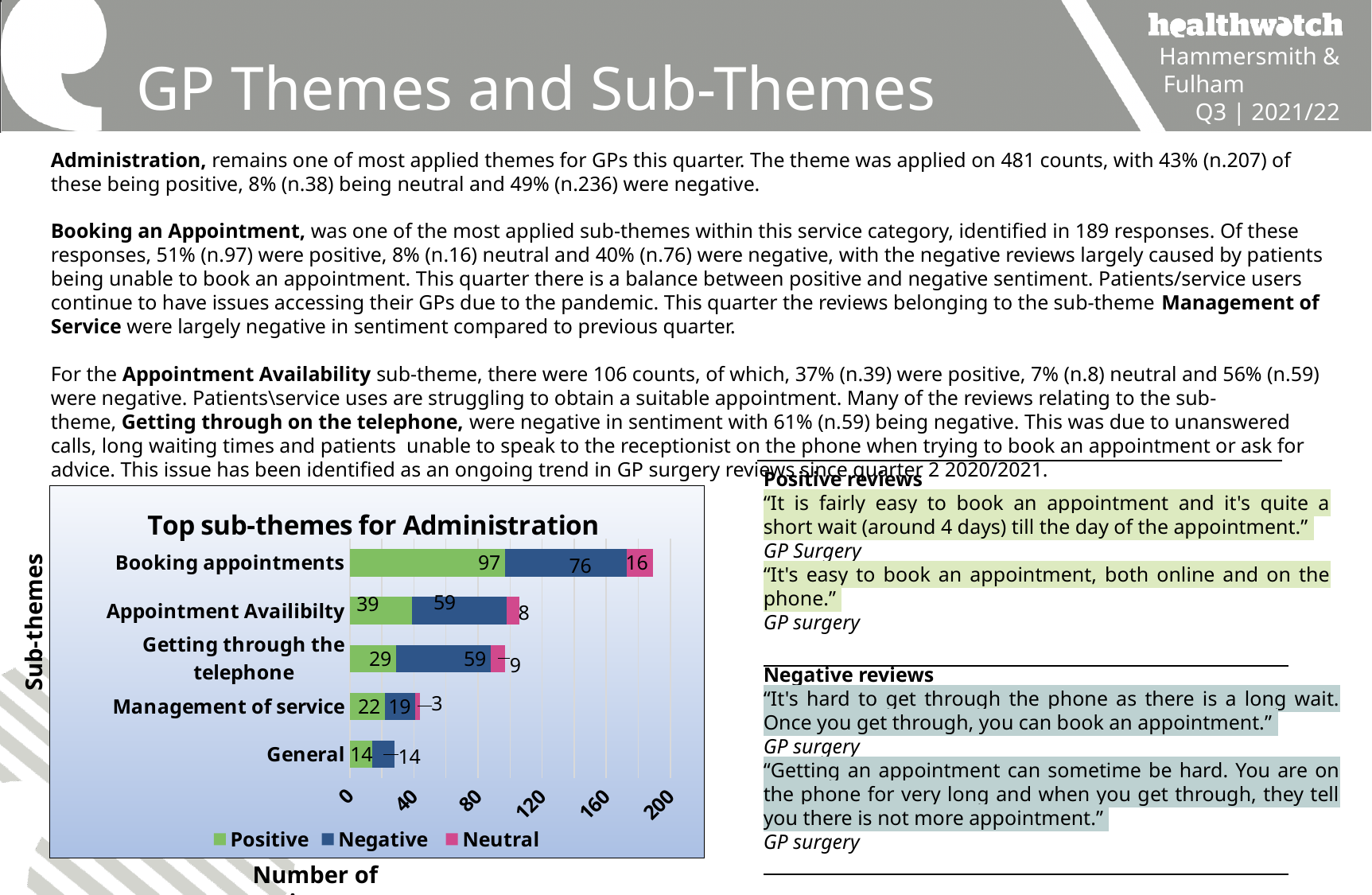
In the 'Top sub-themes for Administration' chart, what is the difference between the Positive and Negative values for Booking appointments? 21 In the 'Top sub-themes for Administration' chart, what is the Negative value for Appointment Availibilty? 59 How many series does the legend of the 'Top sub-themes for Administration' chart list? 3 In the 'Top sub-themes for Administration' chart, which sub-theme has the highest Positive value? Booking appointments In the 'Top sub-themes for Administration' chart, what is the total of the stacked bar for Management of service? 44 In the 'Top sub-themes for Administration' chart, what is the Neutral value for Getting through the telephone? 9 In the 'Top sub-themes for Administration' chart, is the total bar length for Booking appointments greater or less than 160? greater In the 'Top sub-themes for Administration' chart, is the Positive value for Appointment Availibilty larger or smaller than its Negative value? smaller How many sub-themes are shown in the 'Top sub-themes for Administration' chart? 5 In the 'Top sub-themes for Administration' chart, which sub-theme has the lowest Negative value? General What type of chart is 'Top sub-themes for Administration'? stacked bar chart In the 'Top sub-themes for Administration' chart, what is the Positive value for Booking appointments? 97